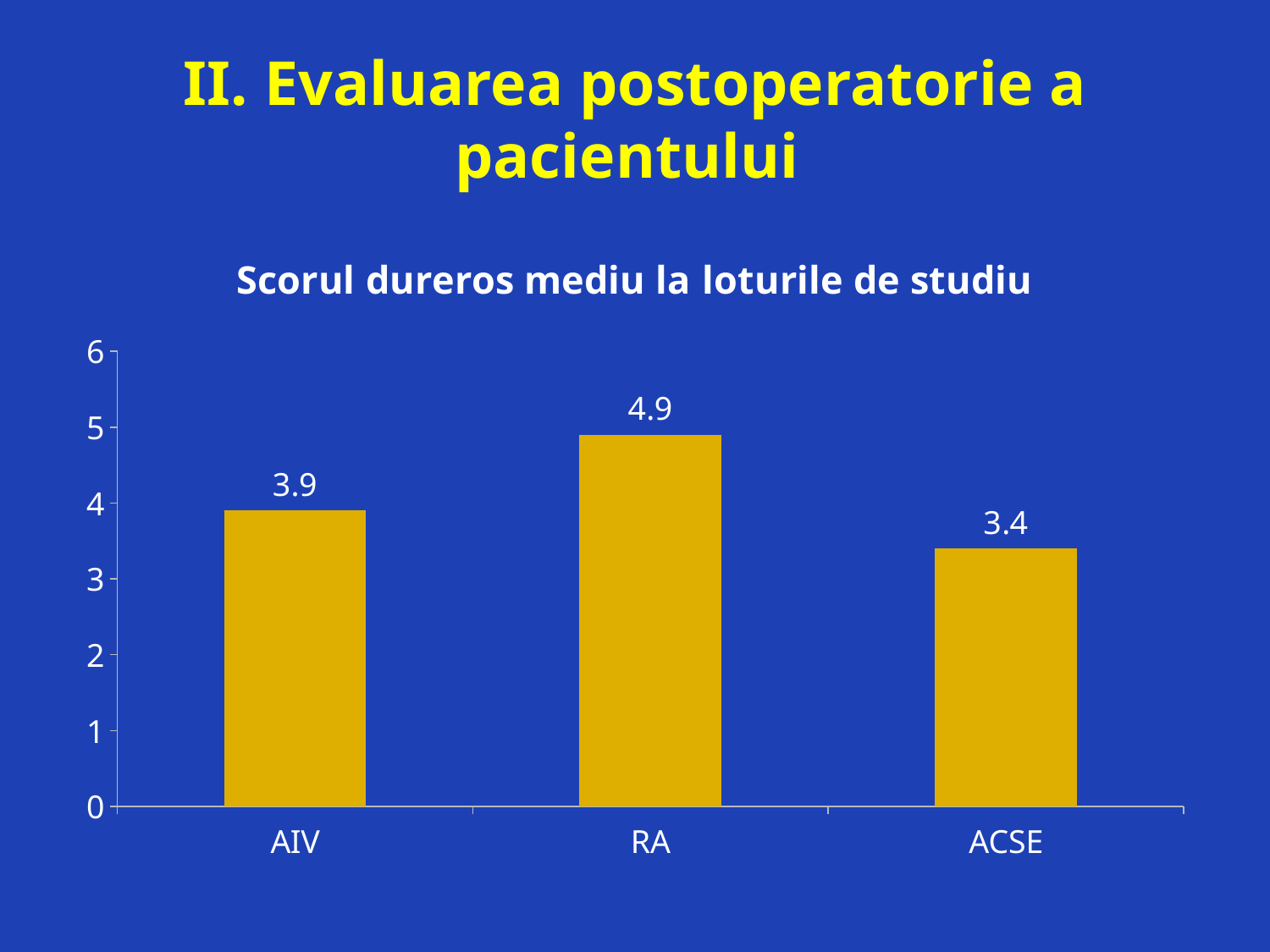
What is the difference between the values for AIV and ACSE? 0.5 What is the value for AIV? 3.9 Which is larger, the value for AIV or the value for ACSE? AIV Which category has the lowest value? ACSE What is the title of the chart? Scorul dureros mediu la loturile de studiu Is the value for RA greater or less than 4? greater How many categories are shown on the x axis? 3 What kind of chart is shown on the slide? bar chart What is the value for RA? 4.9 What is the value for ACSE? 3.4 Which category has the highest value? RA What is the difference between the values for RA and AIV? 1